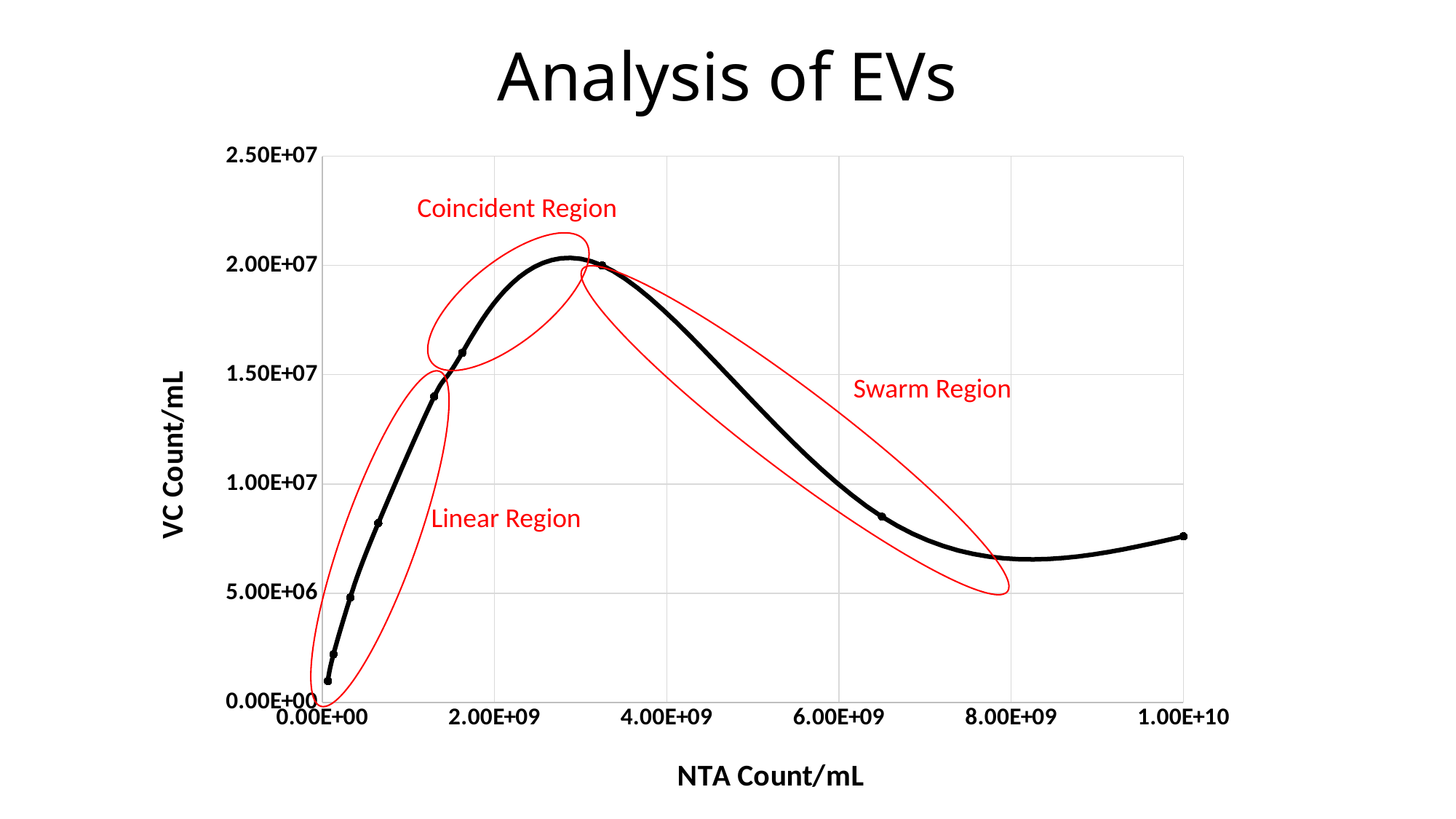
Is the VC Count/mL higher in the Linear Region or in the Coincident Region? Coincident Region Is the VC Count/mL at an NTA Count/mL of 1.00E+10 greater or less than 1.00E+07? less What is the label of the x axis? NTA Count/mL How many labelled regions are marked in red on the chart? 3 What kind of chart is shown on the slide? line chart What is the title of the chart? Analysis of EVs Does the VC Count/mL rise or fall as NTA Count/mL increases from 4.00E+09 to 8.00E+09? fall Is the peak VC Count/mL of the curve greater or less than 1.50E+07? greater Does the VC Count/mL rise or fall as NTA Count/mL increases from 0.00E+00 to 2.00E+09? rise Which labelled region contains the peak of the curve? Coincident Region What is the highest value shown on the y axis? 2.50E+07 Which labelled region contains the lowest point of the curve? Linear Region